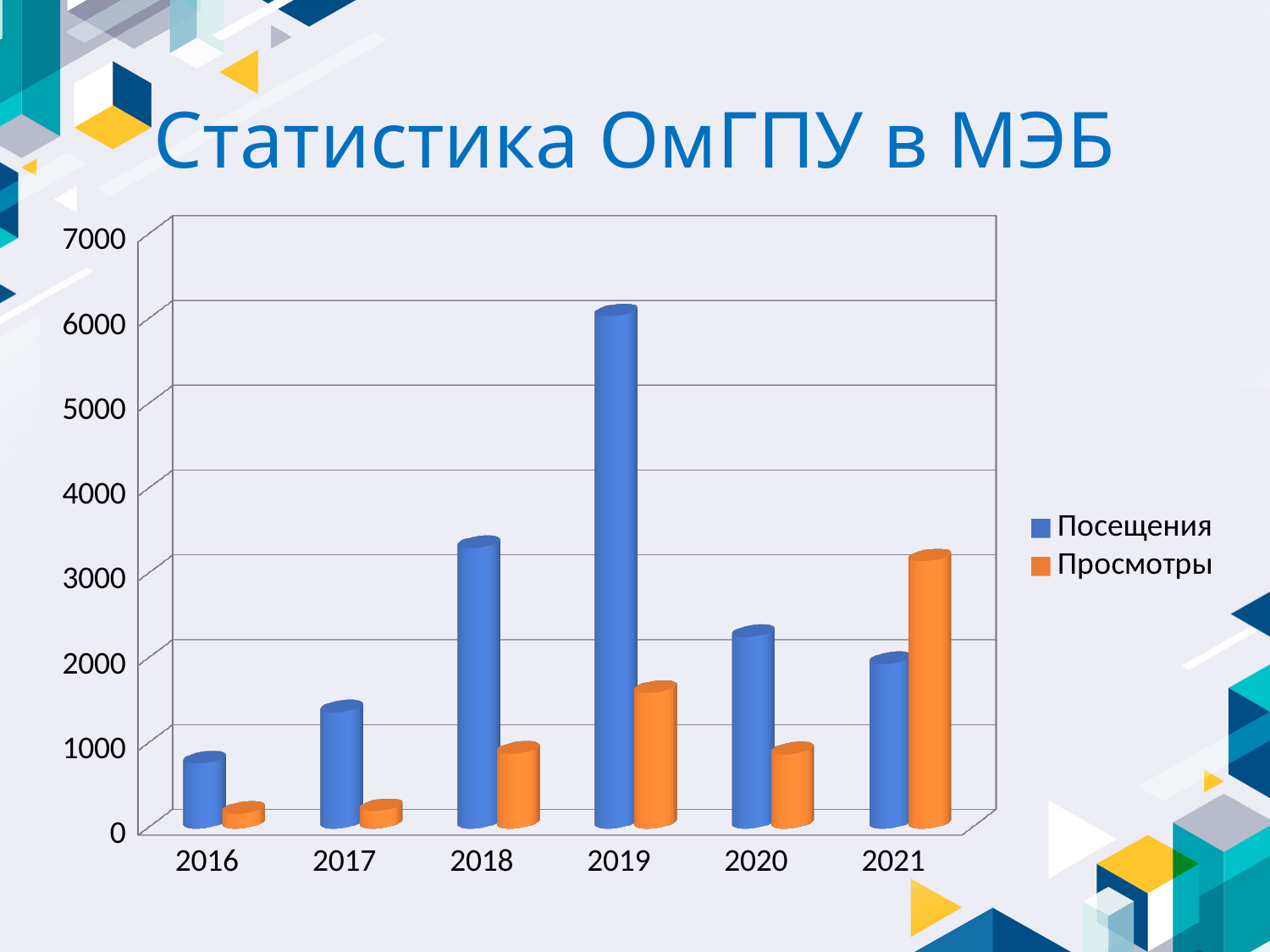
What is the title of the chart? Статистика ОмГПУ в МЭБ In which year is the value for Просмотры highest? 2021 How many series does the legend list? 2 How many years are shown on the x axis? 6 In which year is the value for Посещения highest? 2019 In which year is the value for Посещения lowest? 2016 Is the value for Просмотры in 2021 greater or less than 2000? greater Is the value for Посещения in 2019 greater or less than 5000? greater In 2021, which series has the larger value, Посещения or Просмотры? Просмотры Is the value for Посещения in 2016 greater or less than 1000? less What kind of chart is shown on the slide? bar chart Does the value for Посещения rise or fall from 2019 to 2021? fall